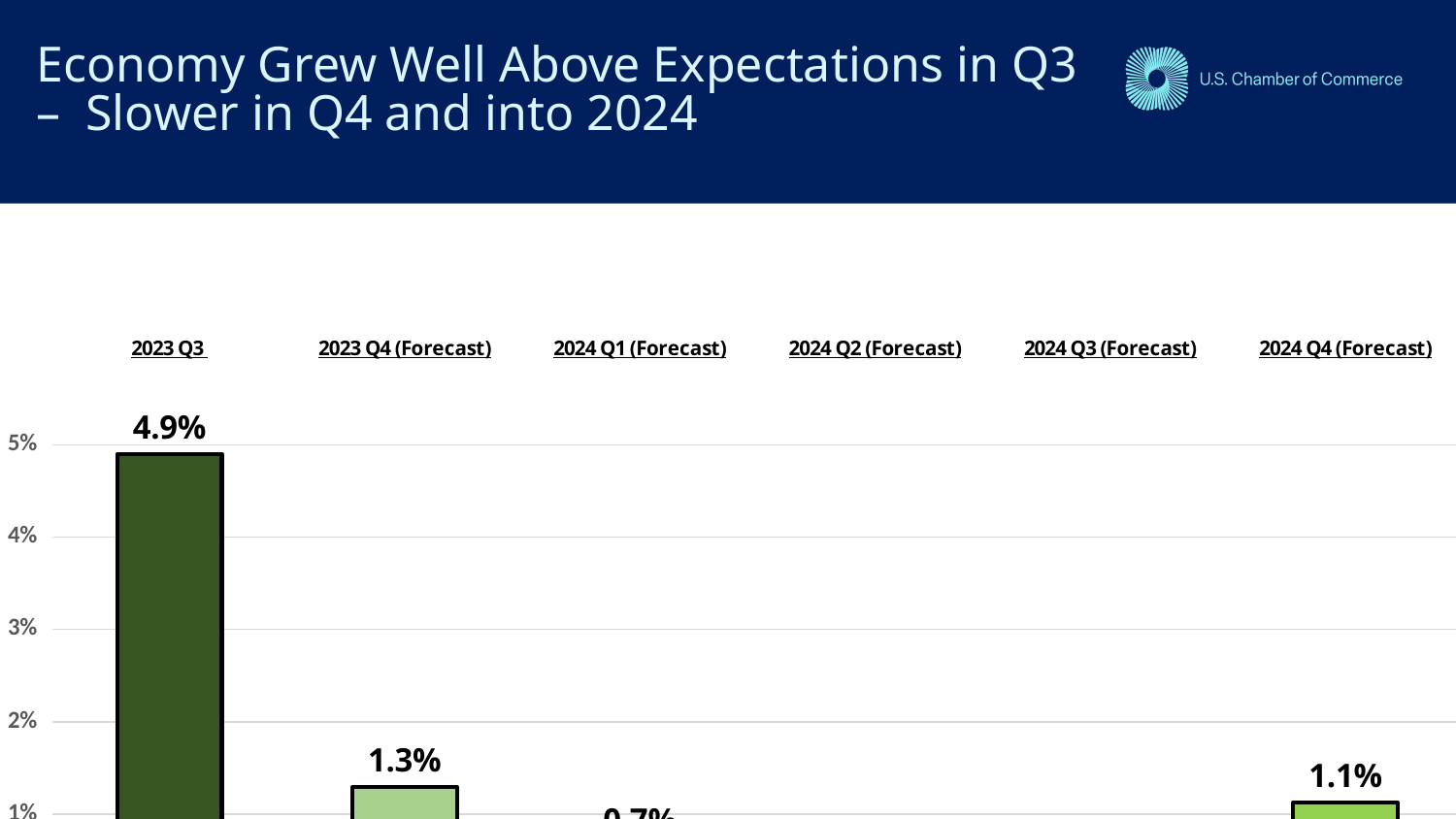
How many quarters are shown on the chart? 6 What is the difference between the values for 2023 Q3 and 2023 Q4 (Forecast)? 3.6 percentage points What is the value for 2024 Q4 (Forecast)? 1.1% Which quarter has the highest value? 2023 Q3 Which quarter is the only one not labeled as a forecast? 2023 Q3 What is the difference between the values for 2023 Q4 (Forecast) and 2024 Q4 (Forecast)? 0.2 percentage points Is the value for 2023 Q3 greater or less than 4%? greater What is the value for 2023 Q4 (Forecast)? 1.3% Which is larger, the value for 2023 Q4 (Forecast) or 2024 Q4 (Forecast)? 2023 Q4 (Forecast) What kind of chart is shown on the slide? bar chart What is the value for 2023 Q3? 4.9% Is the value for 2023 Q4 (Forecast) greater or less than 2%? less